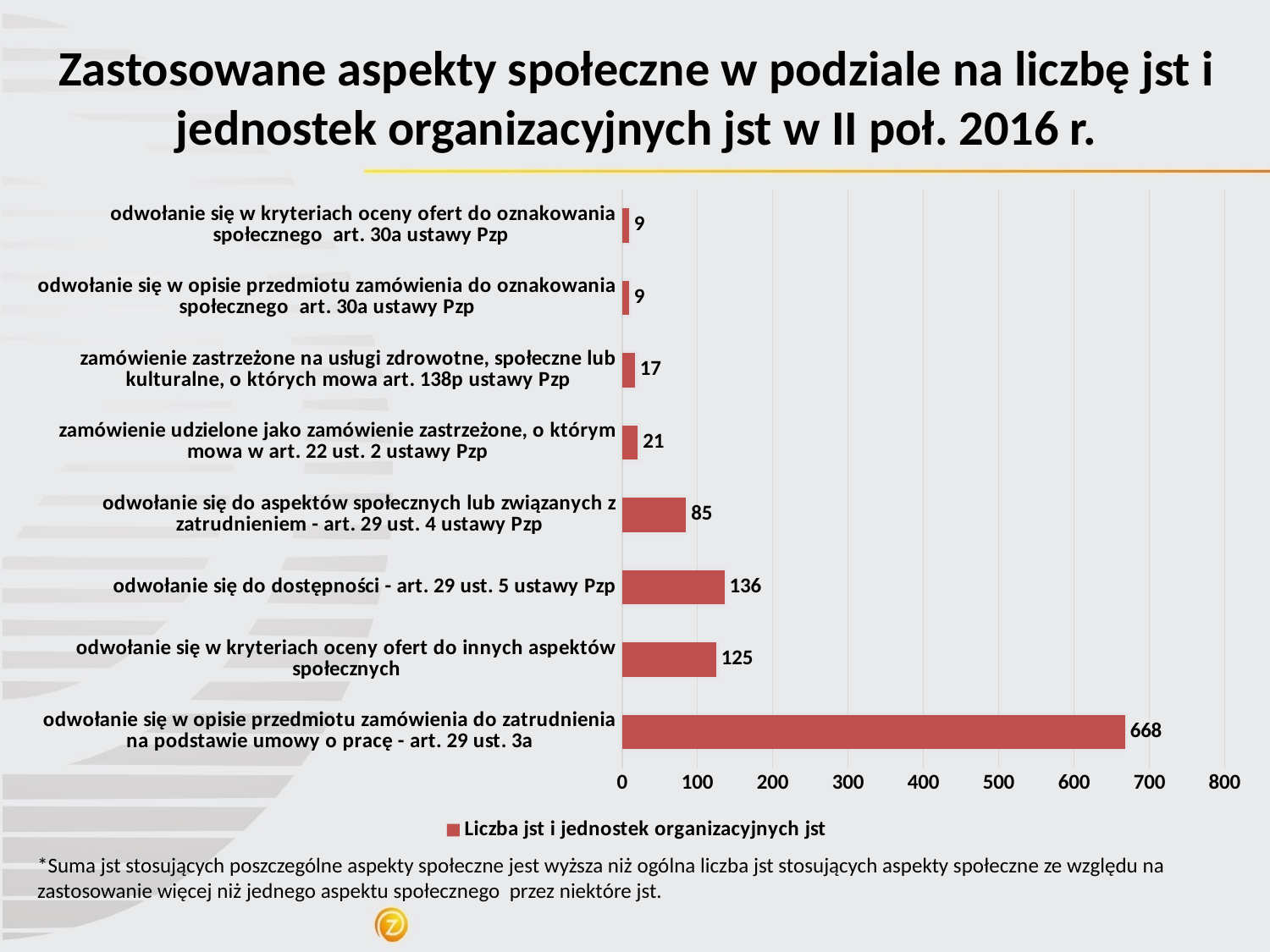
What is the lowest value shown in the chart? 9 Is the value for 'odwołanie się w kryteriach oceny ofert do innych aspektów społecznych' greater or less than 100? greater Which is larger: the value for 'odwołanie się do aspektów społecznych lub związanych z zatrudnieniem - art. 29 ust. 4 ustawy Pzp' or the value for 'zamówienie zastrzeżone na usługi zdrowotne, społeczne lub kulturalne, o których mowa art. 138p ustawy Pzp'? odwołanie się do aspektów społecznych lub związanych z zatrudnieniem - art. 29 ust. 4 ustawy Pzp What kind of chart is shown on the slide? bar chart What is the difference between the values for 'odwołanie się do dostępności - art. 29 ust. 5 ustawy Pzp' and 'odwołanie się w kryteriach oceny ofert do innych aspektów społecznych'? 11 What is the value for 'zamówienie udzielone jako zamówienie zastrzeżone, o którym mowa w art. 22 ust. 2 ustawy Pzp'? 21 What is the value for 'odwołanie się do dostępności - art. 29 ust. 5 ustawy Pzp'? 136 What is the value for 'odwołanie się w opisie przedmiotu zamówienia do zatrudnienia na podstawie umowy o pracę - art. 29 ust. 3a'? 668 How many series does the legend list? 1 How many categories are shown in the chart? 8 Which category has the highest value? odwołanie się w opisie przedmiotu zamówienia do zatrudnienia na podstawie umowy o pracę - art. 29 ust. 3a What is the legend entry of the chart? Liczba jst i jednostek organizacyjnych jst